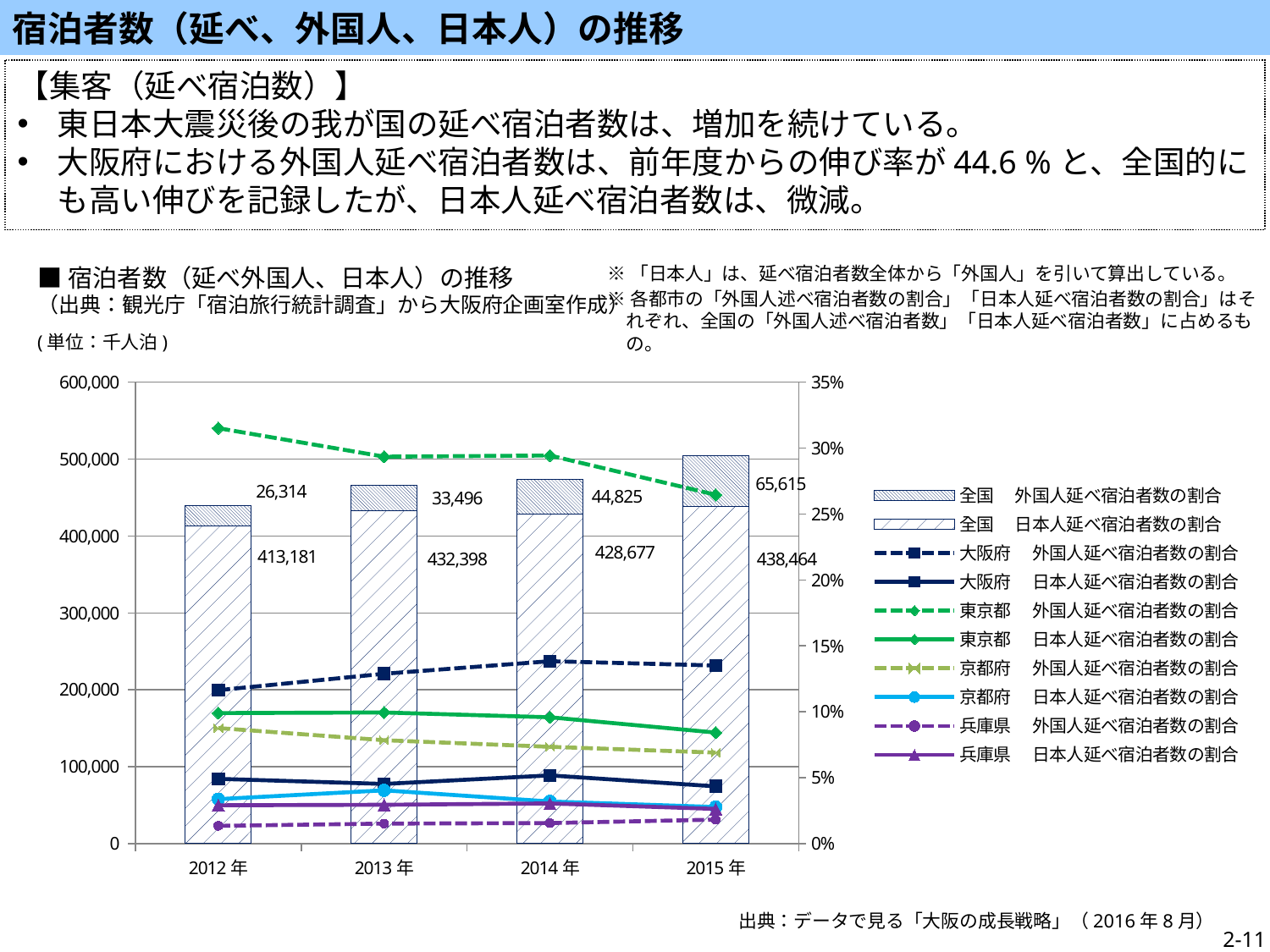
What is the value of 全国 日本人延べ宿泊者数 for 2015年? 438,464 Does the 東京都 外国人延べ宿泊者数の割合 line rise or fall from 2012年 to 2015年? fall What is the value of 全国 外国人延べ宿泊者数 for 2012年? 26,314 How many series does the legend list? 10 Which is larger, 全国 日本人延べ宿泊者数 in 2013年 or in 2014年? 2013年 What is the total of the stacked bar for 2015年 (外国人 plus 日本人)? 504,079 What is the difference between 全国 外国人延べ宿泊者数 in 2015年 and 2014年? 20,790 Is the 東京都 外国人延べ宿泊者数の割合 for 2012年 greater or less than 30%? greater Is the 兵庫県 外国人延べ宿泊者数の割合 for 2014年 greater or less than 5%? less How many years are shown on the x axis? 4 In which year is 全国 日本人延べ宿泊者数 the lowest? 2012年 In which year is 全国 外国人延べ宿泊者数 the highest? 2015年